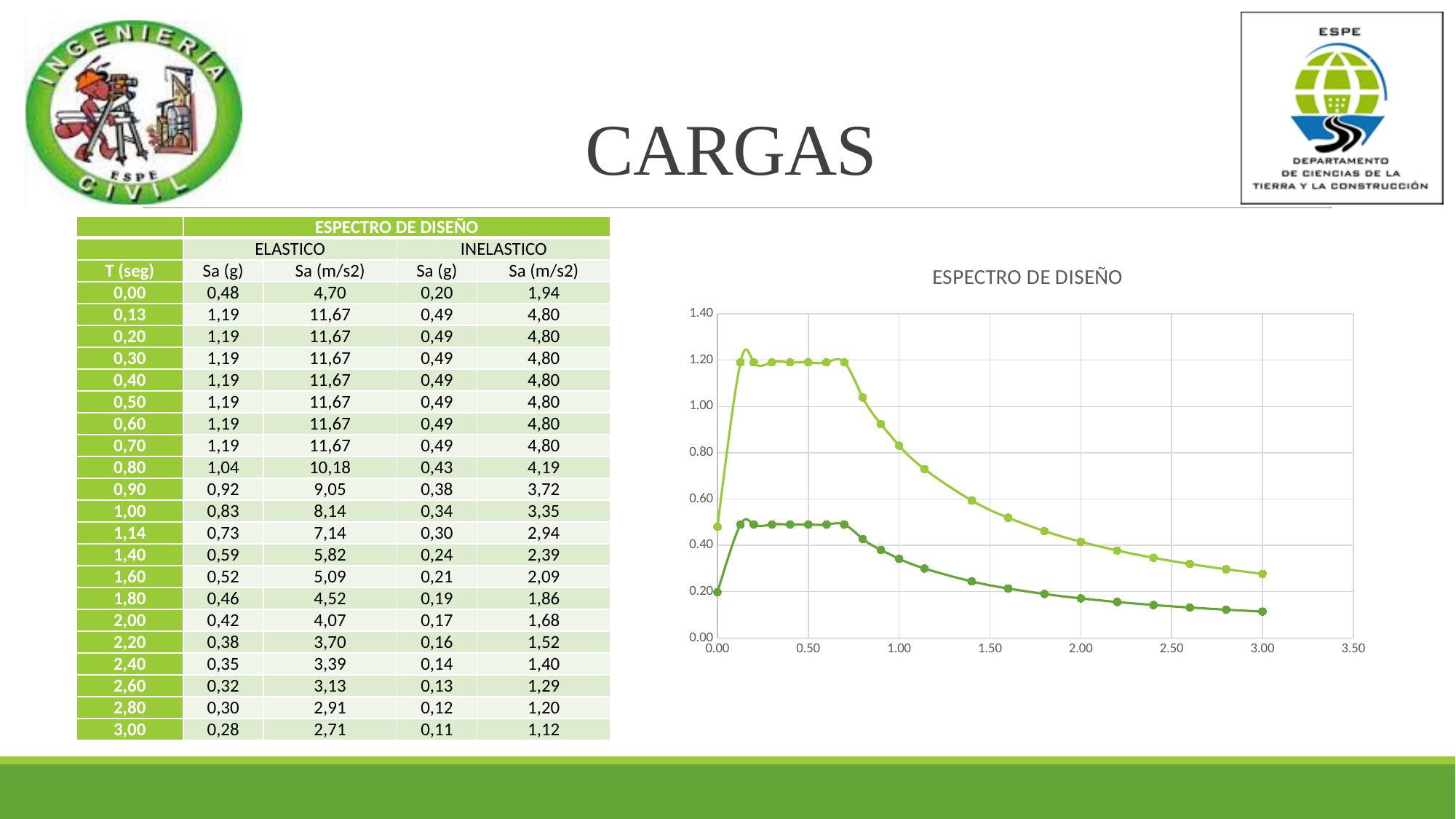
According to the table, what is the inelastic Sa (g) value at T = 3,00 seg? 0,11 According to the table, what is the elastic Sa (g) value at T = 1,00 seg? 0,83 Is the value of the upper (light green) line at 0.50 on the x axis greater or less than 1.00? greater Is the value of the lower (dark green) line at 3.00 on the x axis greater or less than 0.20? less Is the value of the lower (dark green) line at 1.00 on the x axis greater or less than 0.40? less What is the title of the chart? ESPECTRO DE DISEÑO At 1.00 on the x axis, which line has the larger value, the upper light green line or the lower dark green line? the upper light green line Do the values of both lines rise or fall as the x axis goes from 1.00 to 3.00? fall What is the highest value shown on the chart's vertical axis? 1.40 How many lines are plotted on the chart? 2 What kind of chart is shown on the right of the slide? line chart